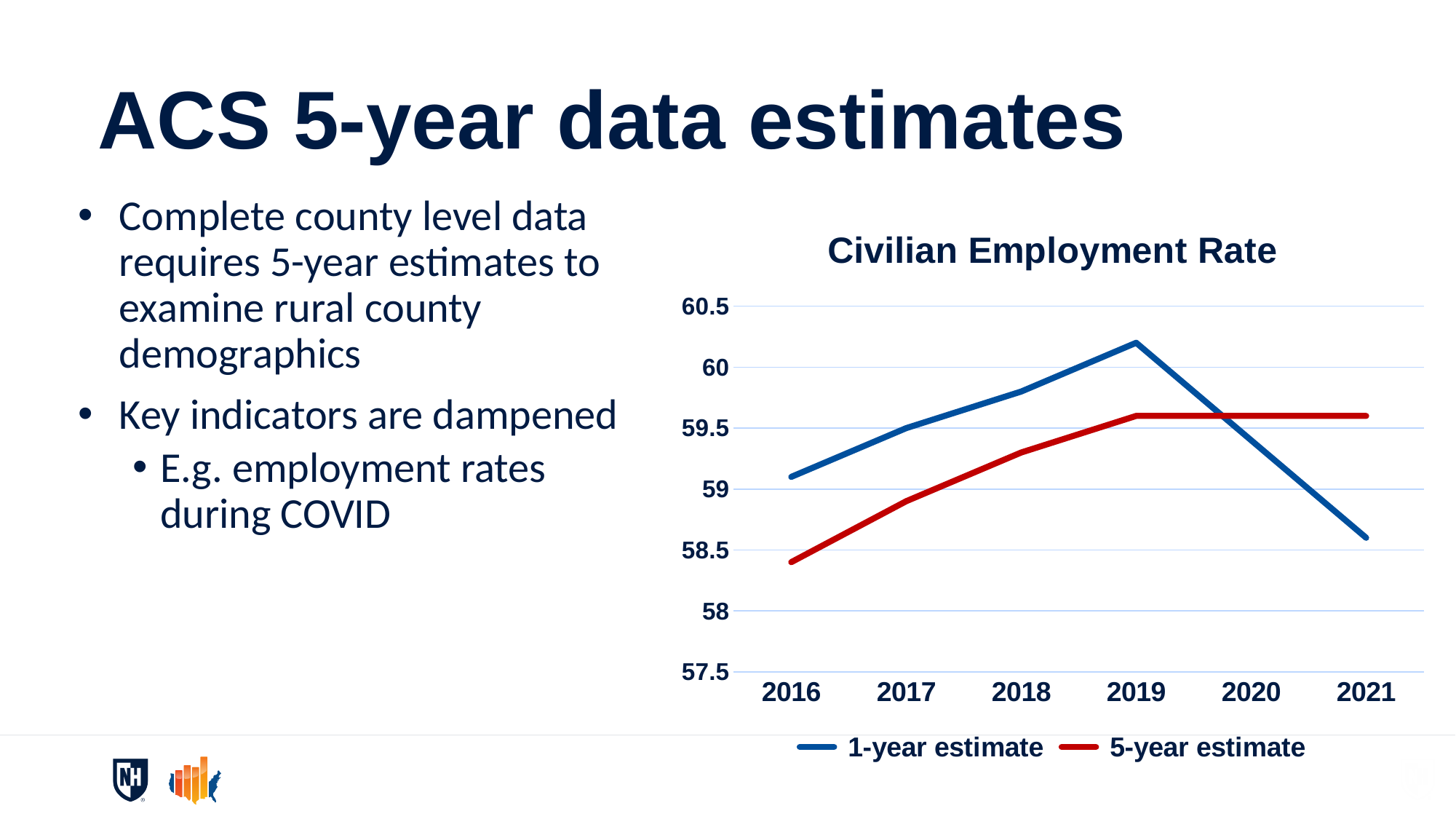
What kind of chart is shown on the slide? line chart Does the 5-year estimate rise or fall from 2016 to 2019? rise How many series does the chart legend list? 2 In which year is the 1-year estimate highest? 2019 Is the 1-year estimate for 2021 greater or less than 59? less In 2021, which is larger: the 1-year estimate or the 5-year estimate? 5-year estimate How many years are shown on the x axis of the chart? 6 What is the title of the chart? Civilian Employment Rate Is the 5-year estimate for 2016 greater or less than 59? less In which year is the 5-year estimate lowest? 2016 Is the 1-year estimate for 2019 greater or less than 60? greater In which year is the 1-year estimate lowest? 2021